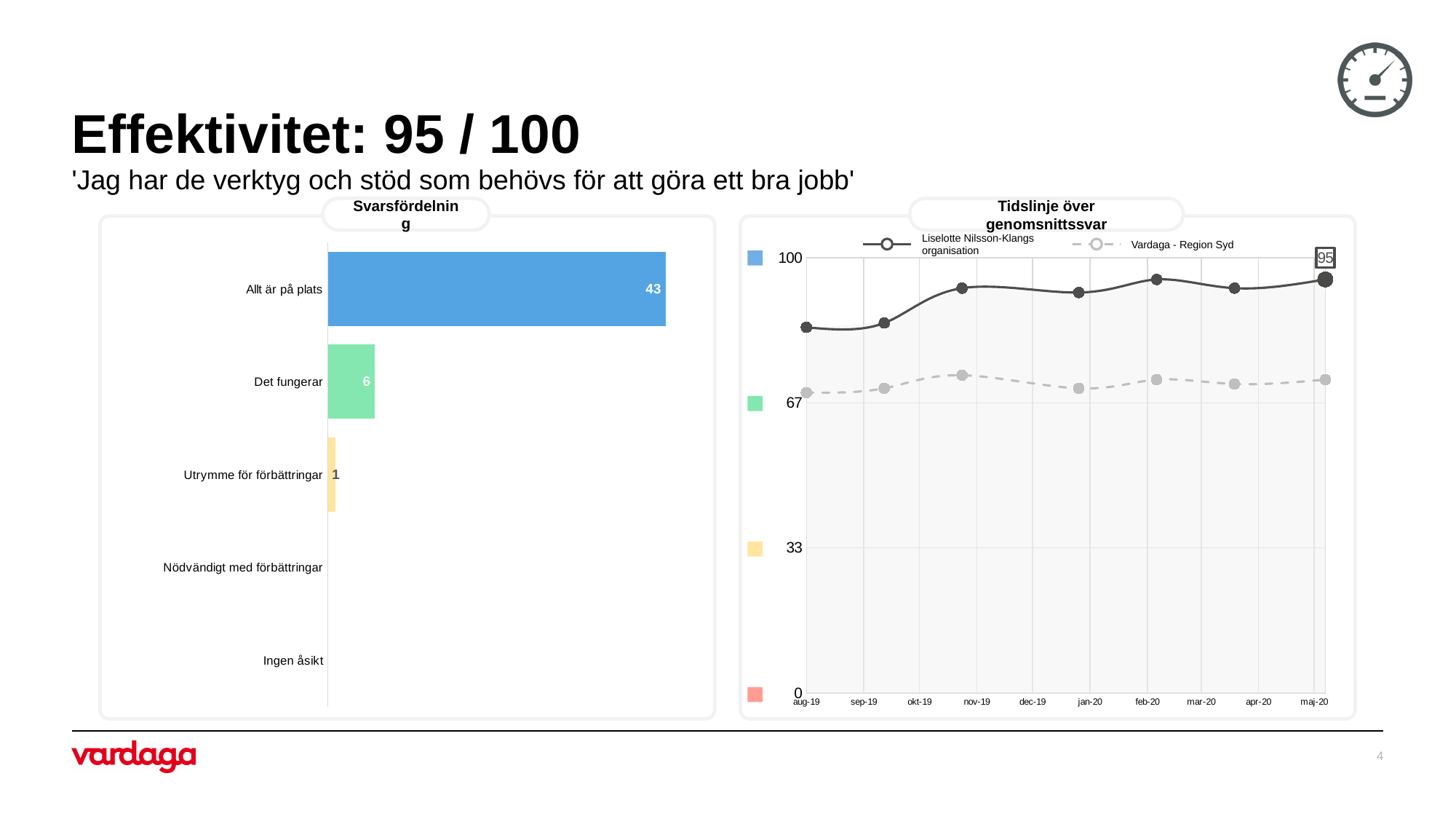
In the 'Tidslinje över genomsnittssvar' chart, what is the value for Liselotte Nilsson-Klangs organisation at maj-20? 95 What kind of chart is the Svarsfördelning chart? Bar chart In the Svarsfördelning chart, what is the value for 'Utrymme för förbättringar'? 1 How many series does the legend of the 'Tidslinje över genomsnittssvar' chart list? 2 In the Svarsfördelning chart, which category has the highest value? Allt är på plats In the Svarsfördelning chart, what is the value for 'Allt är på plats'? 43 In the 'Tidslinje över genomsnittssvar' chart, which series is higher at maj-20: Liselotte Nilsson-Klangs organisation or Vardaga - Region Syd? Liselotte Nilsson-Klangs organisation In the Svarsfördelning chart, what is the difference between 'Allt är på plats' and 'Det fungerar'? 37 How many categories are listed in the Svarsfördelning chart? 5 In the Svarsfördelning chart, what is the value for 'Det fungerar'? 6 In the Svarsfördelning chart, which is larger: 'Det fungerar' or 'Utrymme för förbättringar'? Det fungerar In the 'Tidslinje över genomsnittssvar' chart, is the value for Liselotte Nilsson-Klangs organisation at aug-19 greater or less than 67? greater